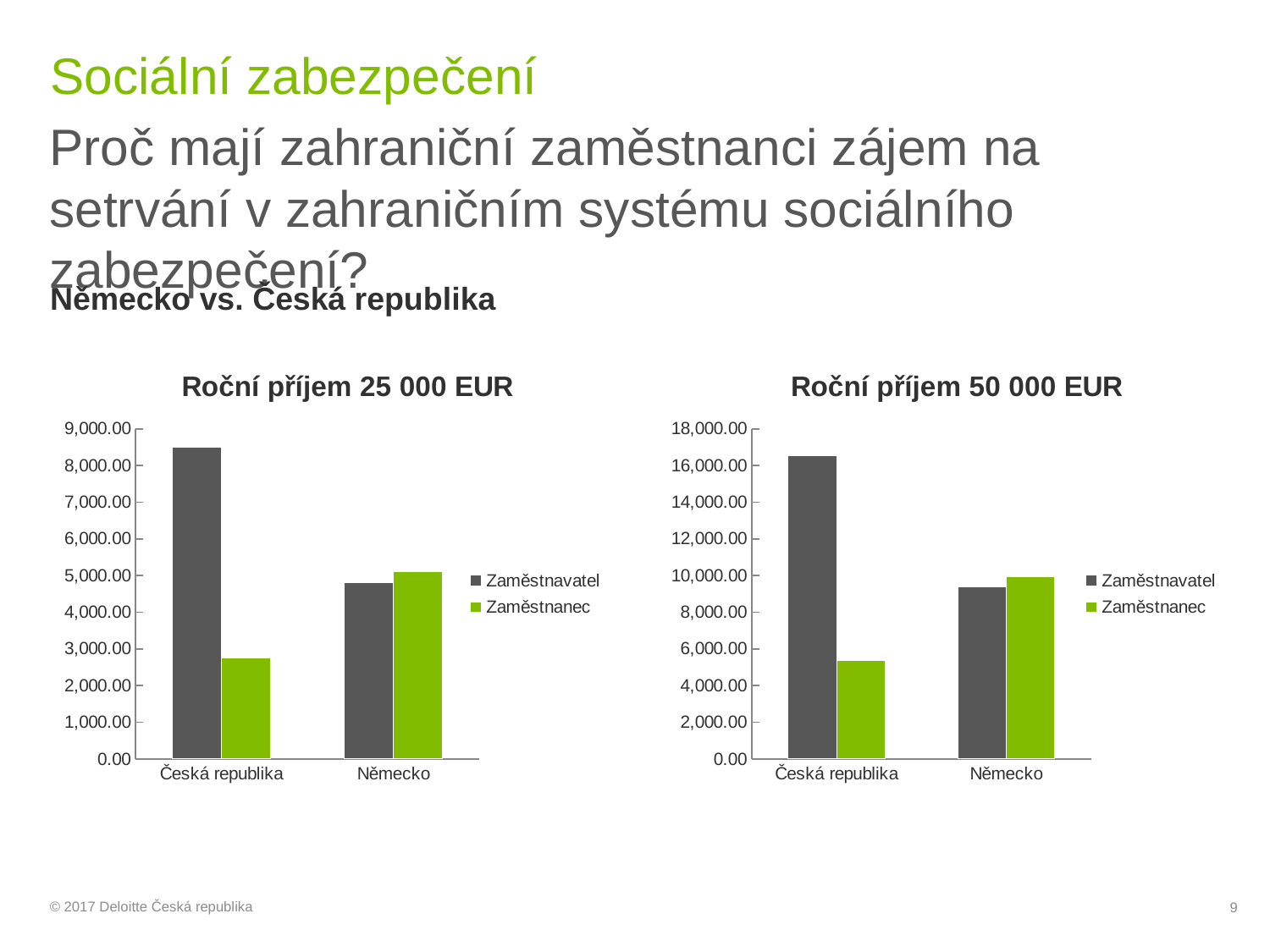
In the 'Roční příjem 50 000 EUR' chart, is the Zaměstnanec value for Česká republika greater or less than 6,000.00? less In the 'Roční příjem 50 000 EUR' chart, is the Zaměstnavatel value for Německo greater or less than 10,000.00? less How many categories are shown on the x axis of the 'Roční příjem 25 000 EUR' chart? 2 What are the titles of the two charts on the slide? Roční příjem 25 000 EUR and Roční příjem 50 000 EUR In the 'Roční příjem 25 000 EUR' chart, which is larger for Česká republika: Zaměstnavatel or Zaměstnanec? Zaměstnavatel How many series does the legend of the 'Roční příjem 50 000 EUR' chart list? 2 In the 'Roční příjem 25 000 EUR' chart, is the Zaměstnanec value for Česká republika greater or less than 3,000.00? less What kind of chart is the 'Roční příjem 25 000 EUR' chart? bar chart In the 'Roční příjem 25 000 EUR' chart, which bar is the lowest? Zaměstnanec for Česká republika In the 'Roční příjem 50 000 EUR' chart, which bar is the tallest? Zaměstnavatel for Česká republika